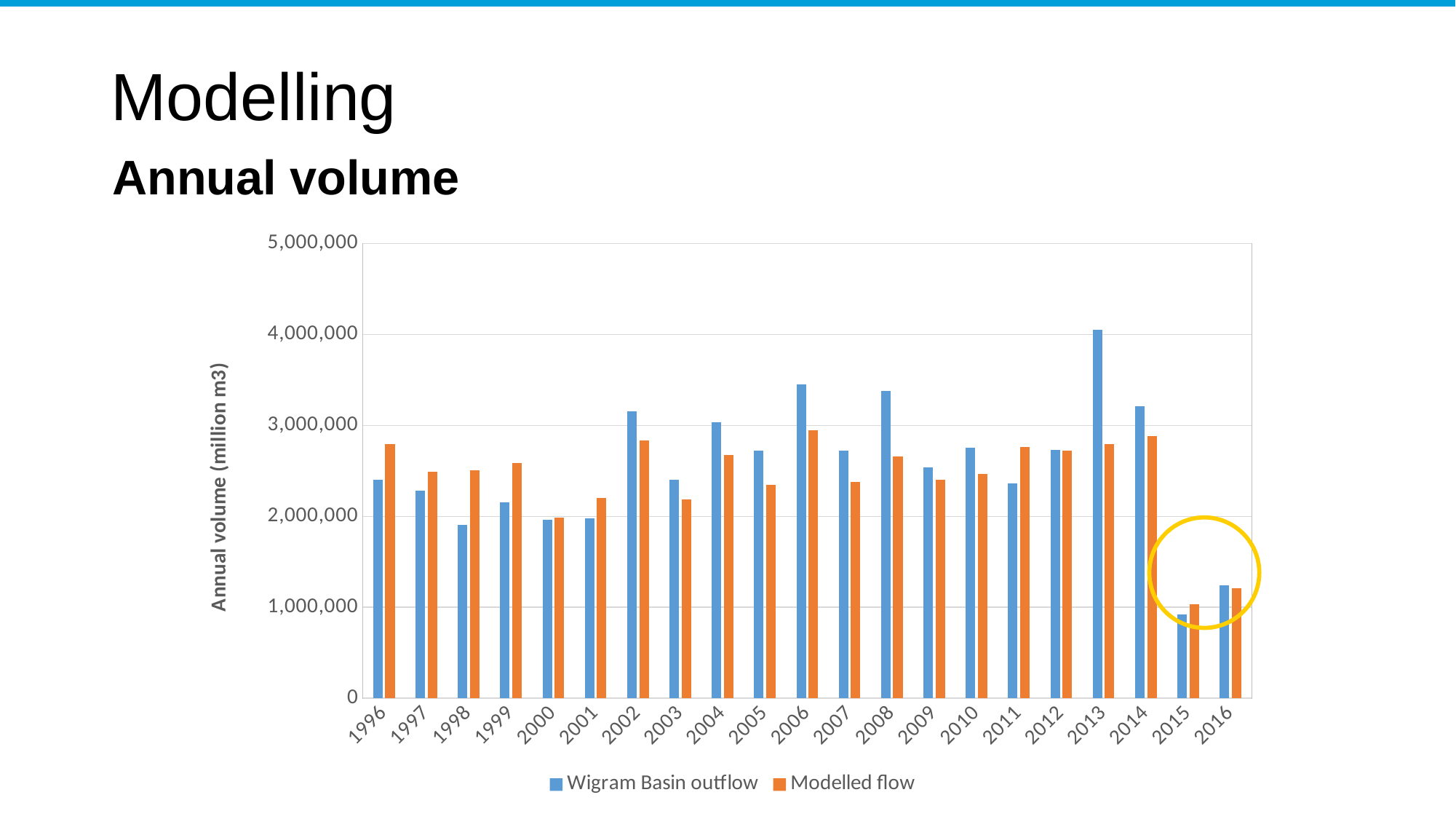
For 2008, which is larger: the Wigram Basin outflow or the Modelled flow? Wigram Basin outflow How many series does the legend list? 2 What kind of chart is shown on the slide? Bar chart Is the Wigram Basin outflow for 2013 greater or less than 3,000,000? greater In which year is the Wigram Basin outflow highest? 2013 What is the title of the vertical axis? Annual volume (million m3) How many years are shown on the x axis? 21 Is the Modelled flow for 1996 greater or less than 2,000,000? greater In which year is the Modelled flow lowest? 2015 For 1996, which is larger: the Wigram Basin outflow or the Modelled flow? Modelled flow Is the Wigram Basin outflow for 2015 greater or less than 1,000,000? less In which year is the Wigram Basin outflow lowest? 2015